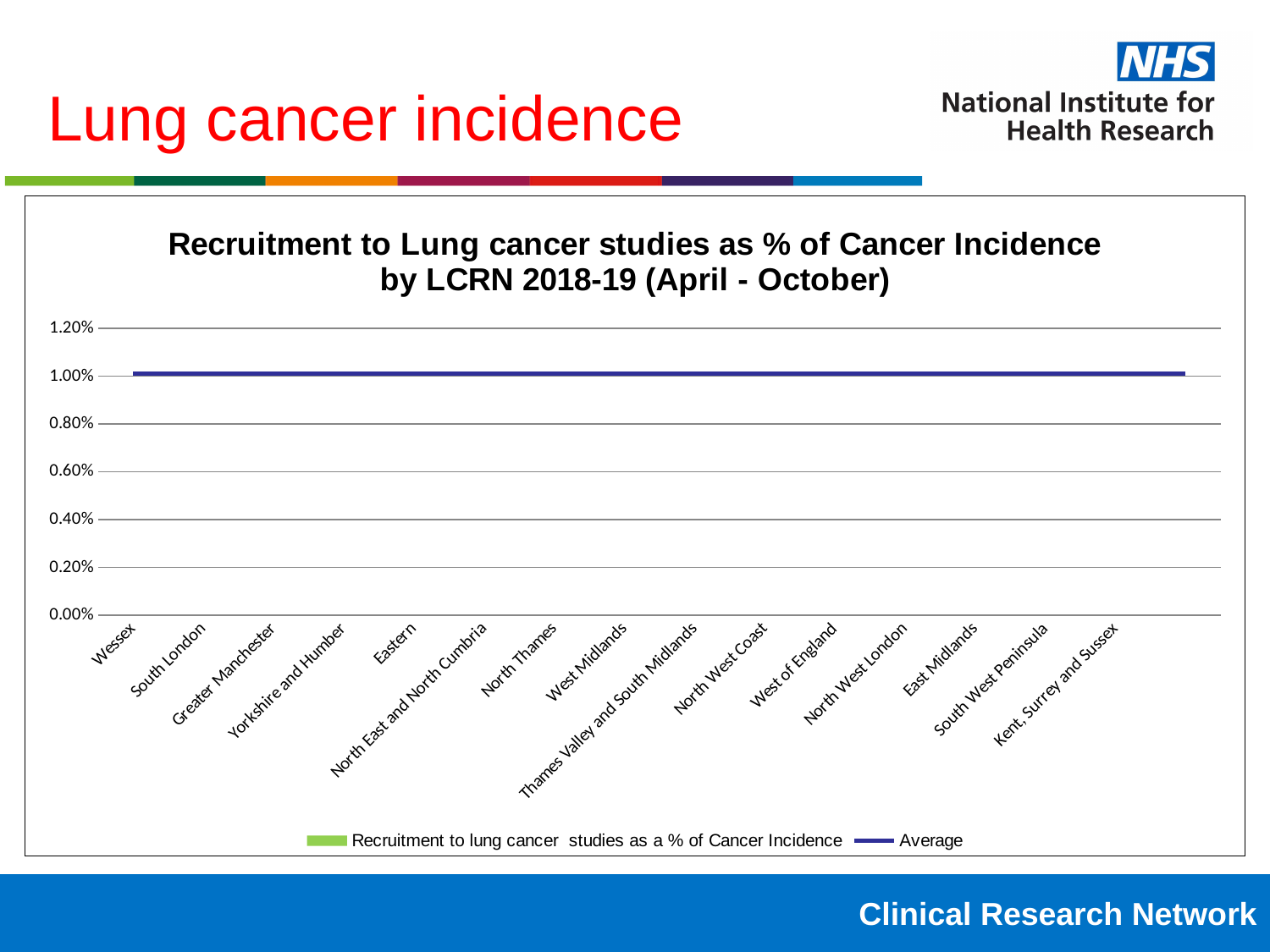
How many series does the chart legend list? 2 How many LCRN categories are shown on the x axis? 15 What is the first LCRN category on the x axis? Wessex What is the title of the chart? Recruitment to Lung cancer studies as % of Cancer Incidence by LCRN 2018-19 (April - October) What is the highest value shown on the y axis? 1.20% Is the Average line greater or less than 1.20%? less Is the Average line greater or less than 0.80%? greater Does the Average line rise, fall, or stay flat across the LCRNs? stay flat